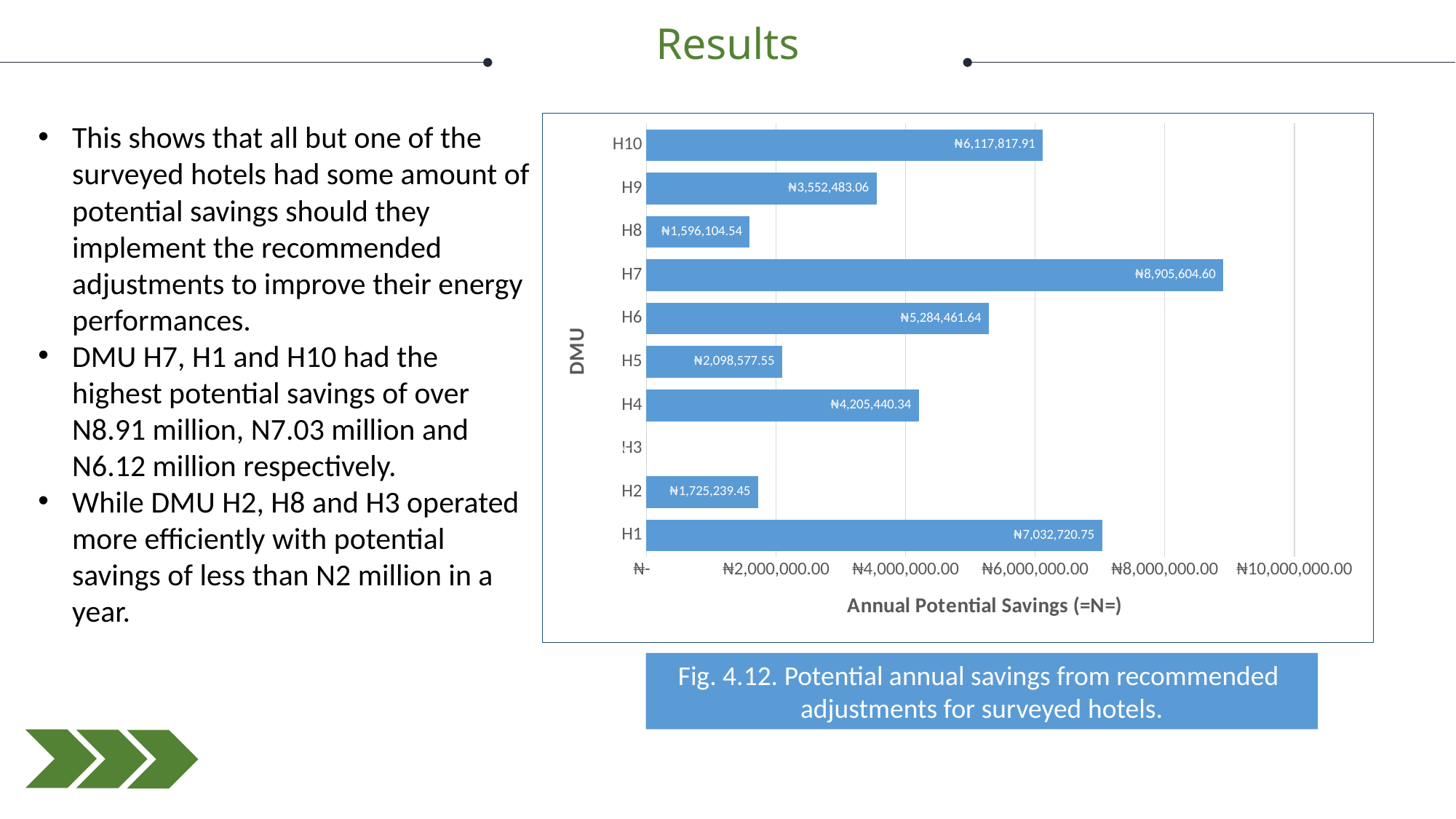
Is the value for H10 greater or less than ₦6,000,000.00? greater What is the annual potential savings value for H5? ₦2,098,577.55 What is the title of the x axis of the chart? Annual Potential Savings (=N=) How many DMU categories are shown on the y axis? 10 What kind of chart is shown on the slide? bar chart Which has larger annual potential savings, H6 or H4? H6 What is the annual potential savings value for H9? ₦3,552,483.06 Among the DMUs with a labeled bar, which has the lowest annual potential savings? H8 What is the annual potential savings value for H1? ₦7,032,720.75 Which DMU has the highest annual potential savings? H7 What is the difference in annual potential savings between H7 and H1? ₦1,872,883.85 What is the annual potential savings value for H7? ₦8,905,604.60